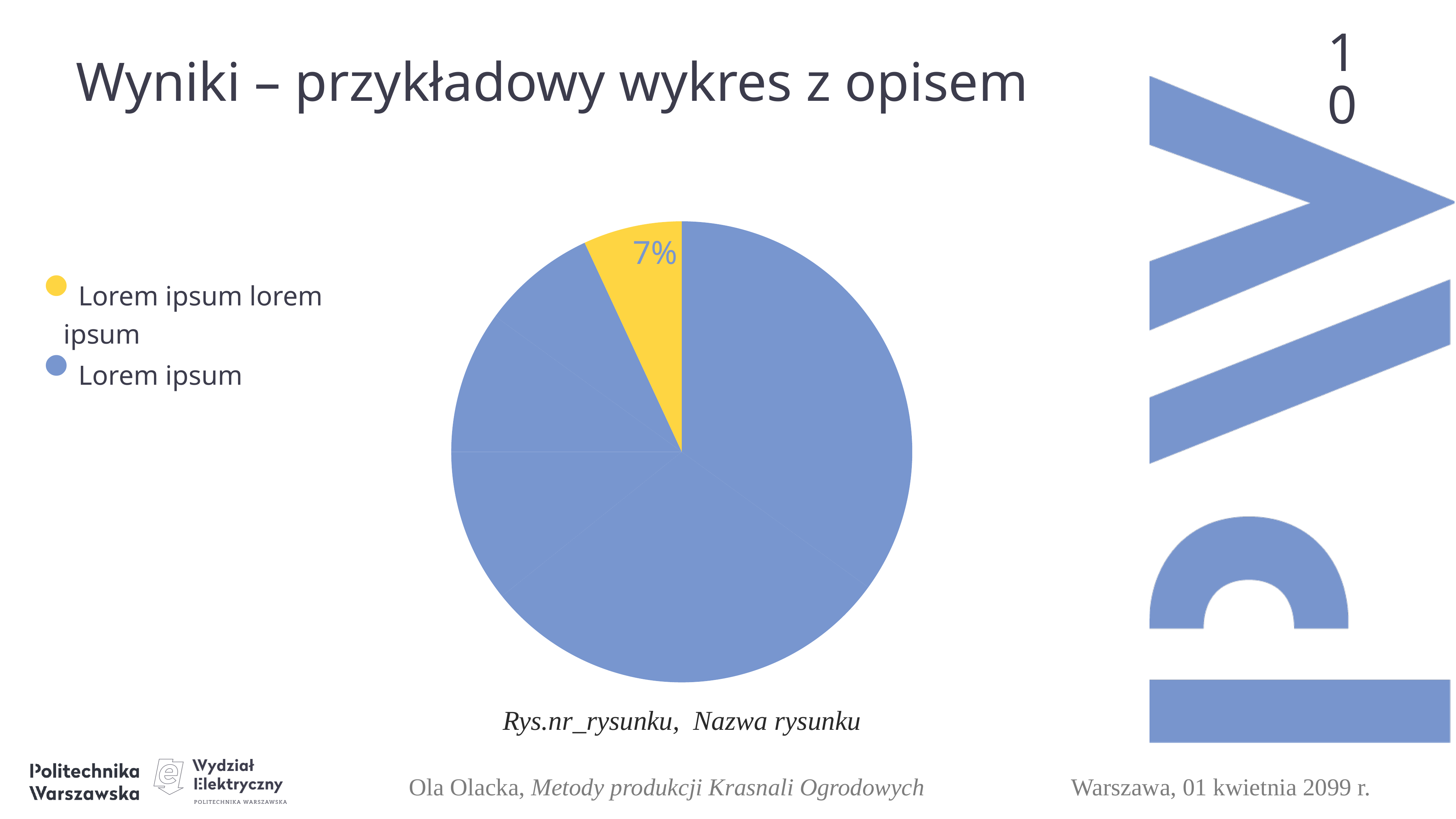
What share of the pie does the yellow slice represent? 7% What percentage is shown for the "Lorem ipsum lorem ipsum" slice of the pie chart? 7% What colour is the slice labelled 7% in the pie chart? yellow Which slice is larger in the pie chart, "Lorem ipsum" or "Lorem ipsum lorem ipsum"? Lorem ipsum What is the caption printed below the pie chart? Rys.nr_rysunku, Nazwa rysunku Which category has the smallest slice in the pie chart? Lorem ipsum lorem ipsum What kind of chart is shown on the slide? pie chart Which category has the largest slice in the pie chart? Lorem ipsum How many entries does the legend of the pie chart list? 2 Is the share of the "Lorem ipsum lorem ipsum" slice greater or less than 10%? less